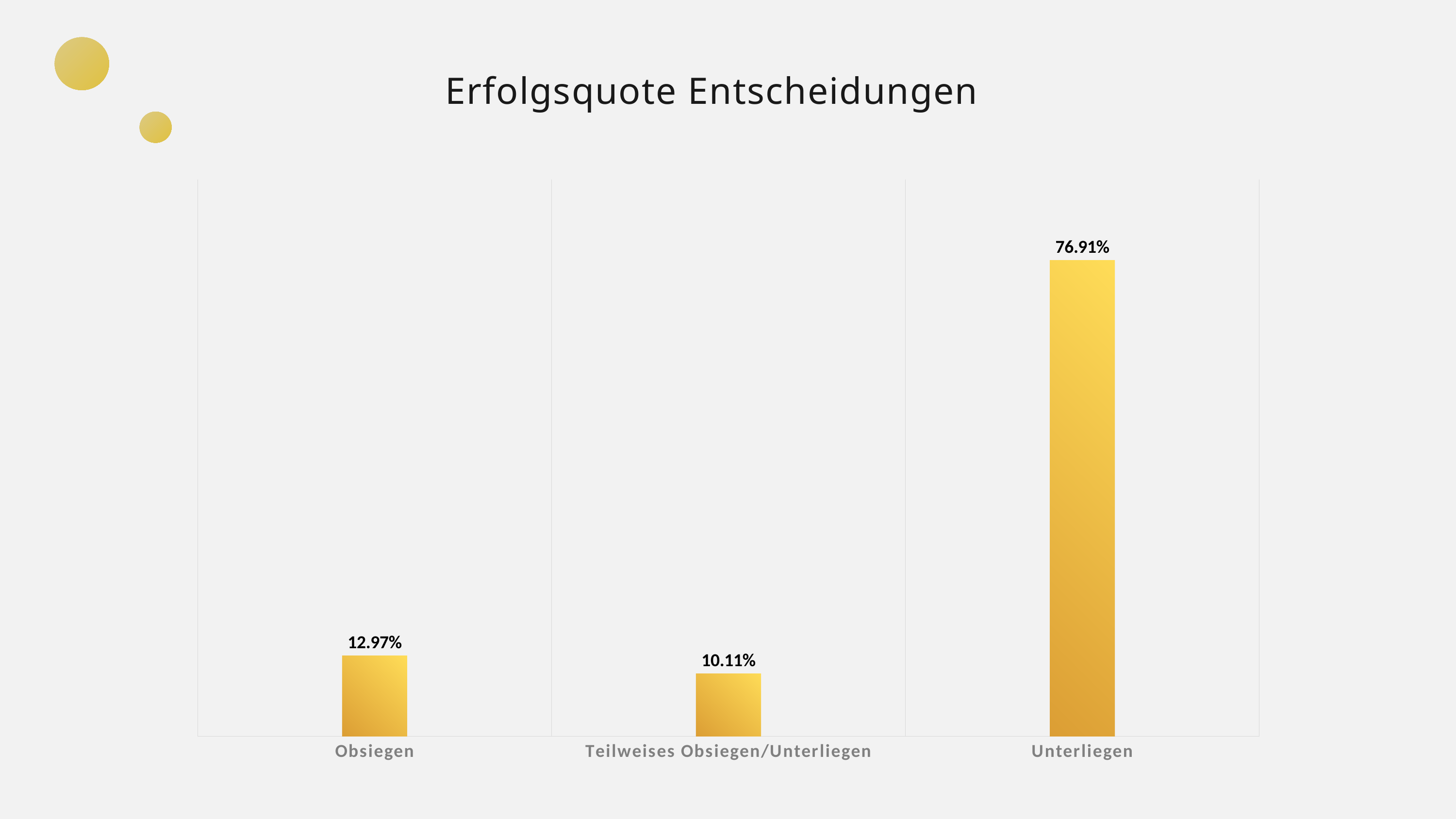
What is the difference between the values for Unterliegen and Obsiegen? 63.94% What is the total of the three values shown in the chart? 99.99% What is the value for Teilweises Obsiegen/Unterliegen? 10.11% How many categories are shown in the chart? 3 What is the difference between the values for Obsiegen and Teilweises Obsiegen/Unterliegen? 2.86% What is the title of the chart? Erfolgsquote Entscheidungen Which category has the highest value? Unterliegen Which category has the lowest value? Teilweises Obsiegen/Unterliegen What kind of chart is shown on the slide? bar chart What is the value for Obsiegen? 12.97% Which is larger, the value for Obsiegen or the value for Unterliegen? Unterliegen What is the value for Unterliegen? 76.91%